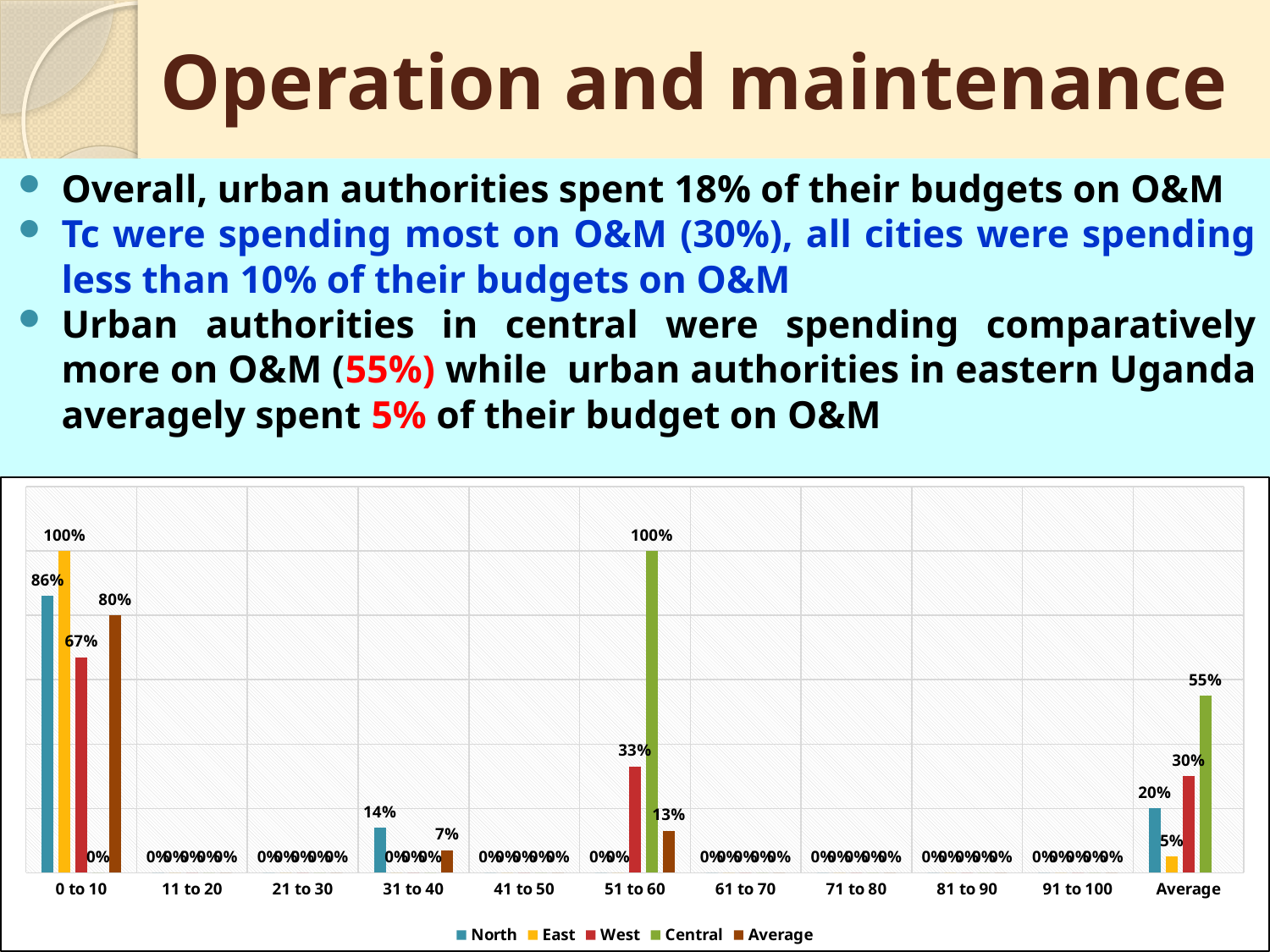
In the Average category, which region has the lowest value? East What is the difference between the North and West values in the 0 to 10 category? 19 percentage points What is the value for Central in the 51 to 60 category? 100% What is the value for North in the 31 to 40 category? 14% In the Average category, which region has the highest value? Central What is the value for Central in the Average category? 55% What is the value for the Average series in the 0 to 10 category? 80% How many categories are shown along the x axis of the chart? 11 How many series does the chart legend list? 5 What is the value for East in the 0 to 10 category? 100% In the Average category, which is larger: the value for West or the value for North? West What kind of chart is shown on the slide? Bar chart